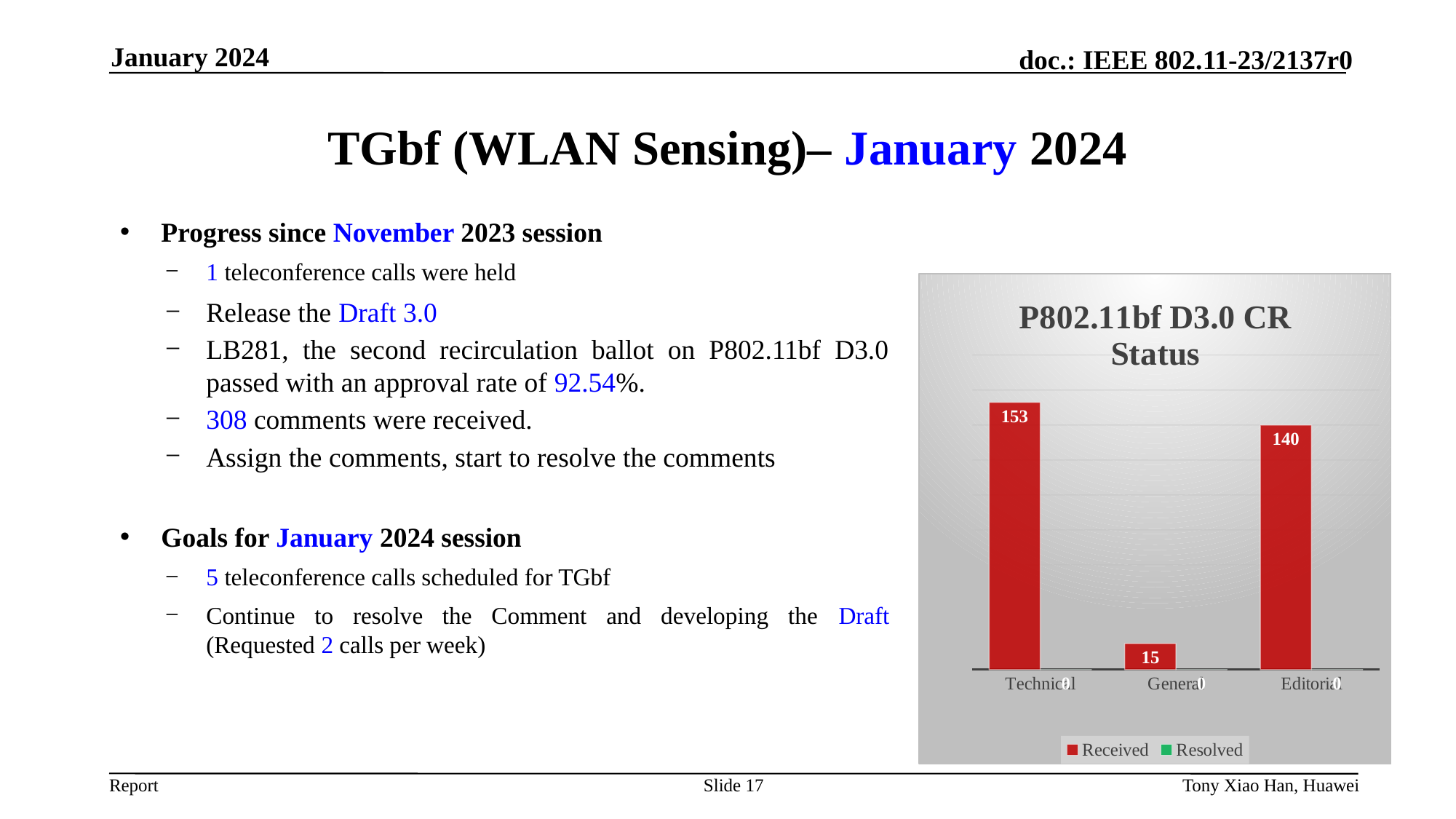
How many series does the chart legend list? 2 What is the Received value for General comments? 15 What is the title of the chart? P802.11bf D3.0 CR Status Which has more Received comments, Technical or Editorial? Technical Which category has the lowest number of Received comments? General Which category has the highest number of Received comments? Technical What is the Received value for Editorial comments? 140 What kind of chart is shown on the slide? Bar chart What is the difference between the Received values for Technical and Editorial? 13 How many categories are shown on the x axis of the chart? 3 What is the Received value for Technical comments? 153 What is the difference between the Received values for Editorial and General? 125